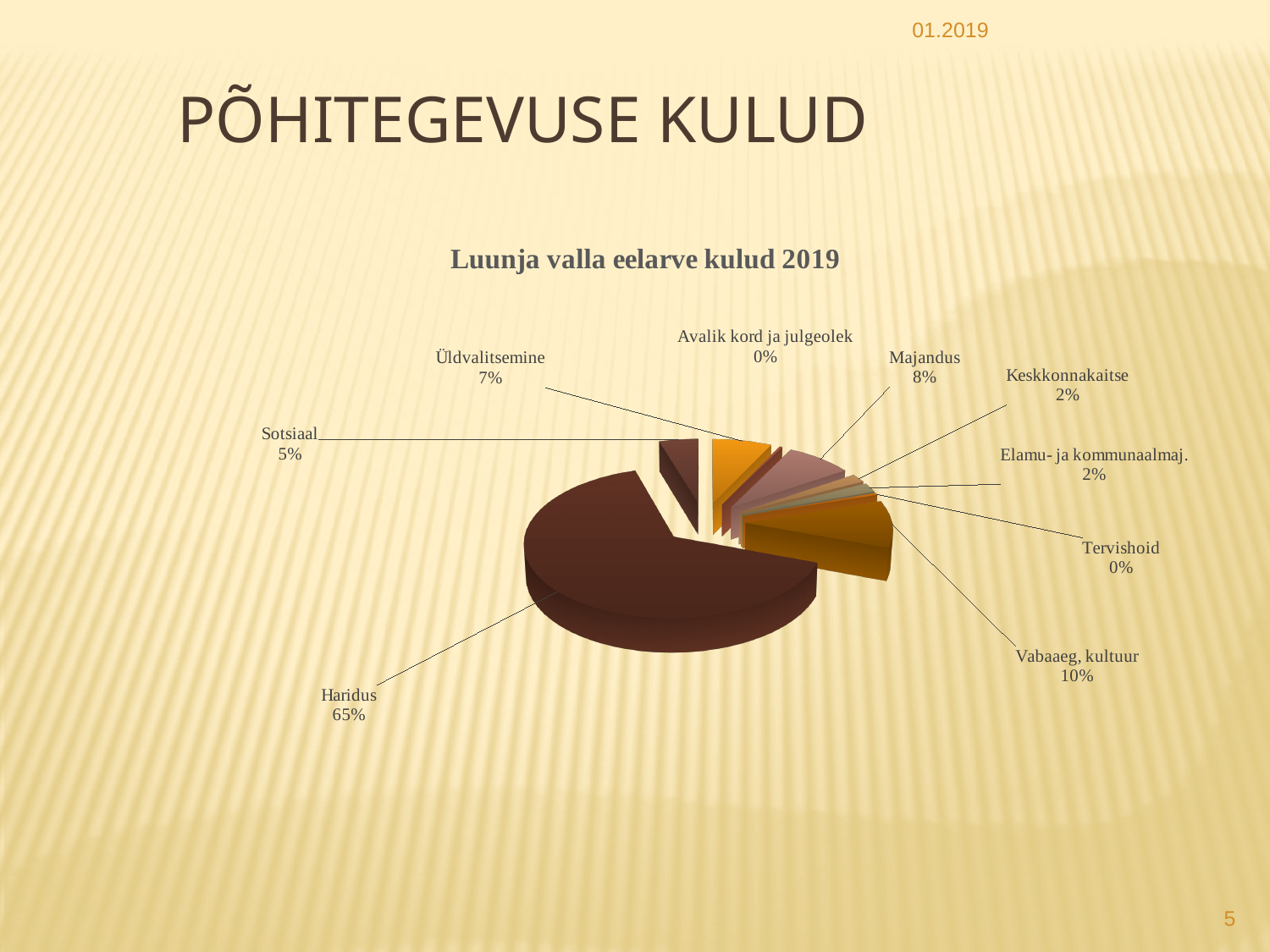
Which has a larger share, Majandus or Üldvalitsemine? Majandus What percentage is shown for Vabaaeg, kultuur? 10% What percentage is shown for Sotsiaal? 5% What percentage is shown for Üldvalitsemine? 7% How many categories are shown in the pie chart? 9 What kind of chart is shown on the slide? Pie chart What is the title of the chart? Luunja valla eelarve kulud 2019 What share of the pie does Haridus represent? 65% What is the difference in percentage points between Haridus and Vabaaeg, kultuur? 55 What percentage is shown for Keskkonnakaitse? 2% What percentage is shown for Majandus? 8% Which category has the largest share of the pie? Haridus